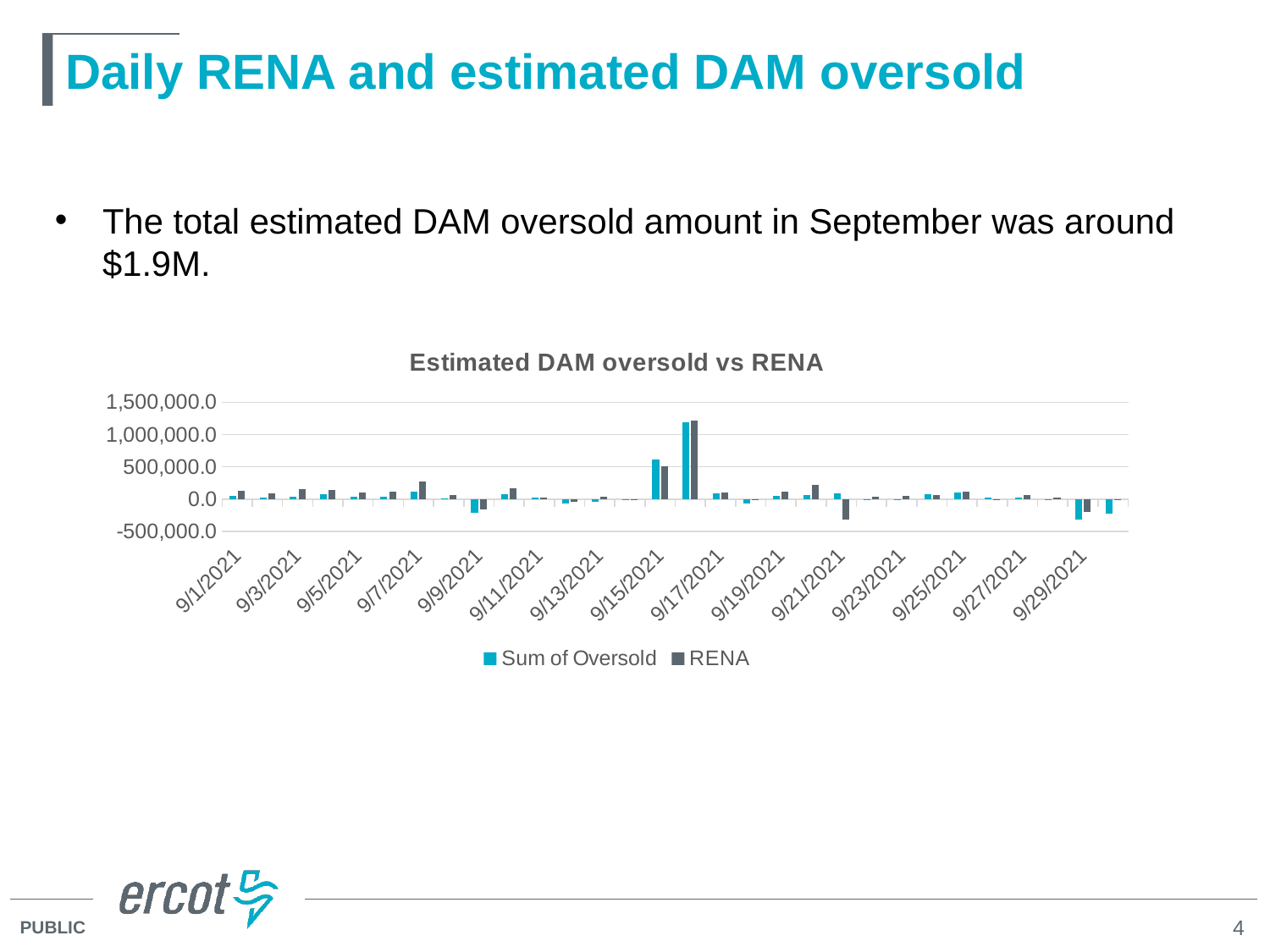
What is the title of the chart? Estimated DAM oversold vs RENA How many date labels are shown along the x axis of the chart? 15 What is the highest value shown on the y axis of the chart? 1,500,000.0 Is the value for Sum of Oversold on 9/15/2021 greater or less than 1,000,000.0? less Is the value for RENA on 9/21/2021 greater or less than 0.0? less What kind of chart is shown on the slide? Bar chart Is the value for Sum of Oversold on 9/1/2021 greater or less than 500,000.0? less On 9/21/2021, which series has the larger value, Sum of Oversold or RENA? Sum of Oversold Which two series are listed in the chart legend? Sum of Oversold and RENA How many series does the legend of the chart list? 2